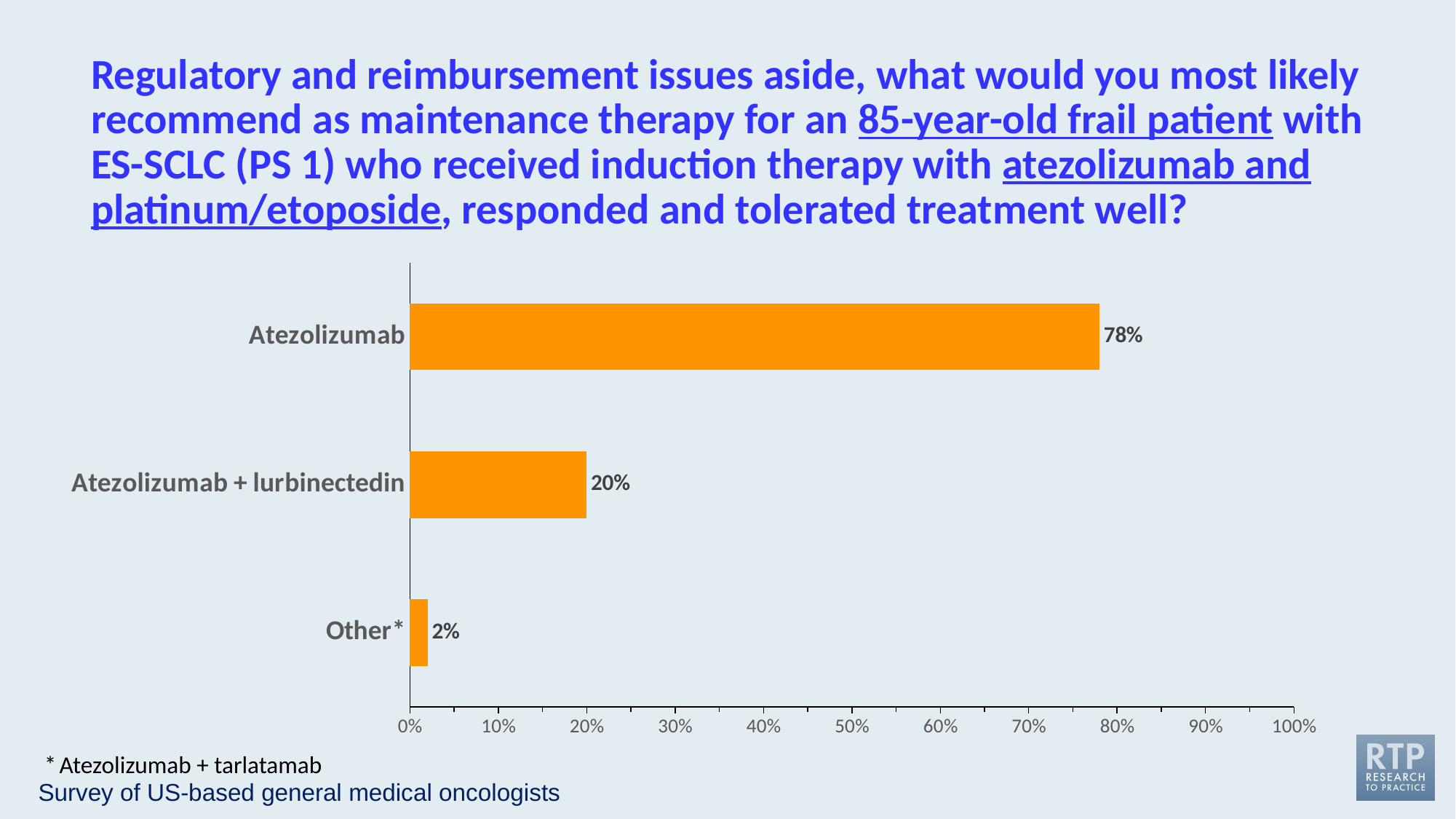
Which option received the highest percentage of responses? Atezolizumab What is the difference in percentage points between Atezolizumab and Atezolizumab + lurbinectedin? 58 What type of chart is shown on the slide? Bar chart Is the value for Atezolizumab greater or less than 70%? greater What percentage of respondents chose Other*? 2% According to the footnote, what does Other* refer to? Atezolizumab + tarlatamab How many response options are shown in the chart? 3 What percentage of respondents would recommend Atezolizumab alone as maintenance therapy? 78% Which received a larger share of responses, Atezolizumab + lurbinectedin or Other*? Atezolizumab + lurbinectedin What is the difference in percentage points between Atezolizumab + lurbinectedin and Other*? 18 Which option received the lowest percentage of responses? Other* What percentage of respondents chose Atezolizumab + lurbinectedin? 20%